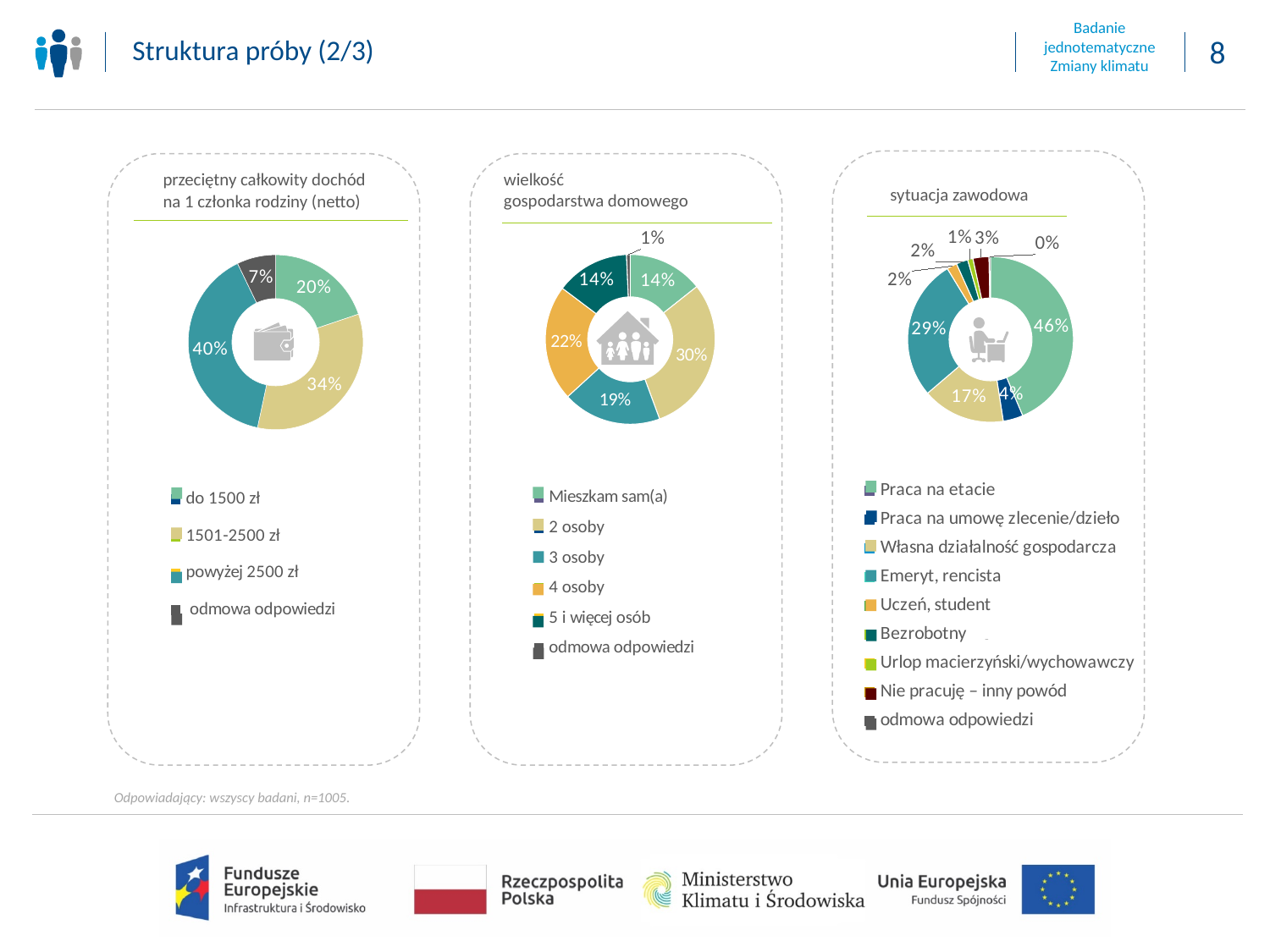
In the chart titled 'przeciętny całkowity dochód na 1 członka rodziny (netto)', what share is 'powyżej 2500 zł'? 40% In the chart titled 'przeciętny całkowity dochód na 1 członka rodziny (netto)', what is the difference between '1501-2500 zł' and 'do 1500 zł'? 14 percentage points In the chart titled 'sytuacja zawodowa', which category has the largest share? Praca na etacie In the chart titled 'sytuacja zawodowa', how many categories does the legend list? 9 In the chart titled 'wielkość gospodarstwa domowego', how many categories does the legend list? 6 What type of chart is used for 'sytuacja zawodowa'? Donut (pie) chart In the chart titled 'wielkość gospodarstwa domowego', what share is '2 osoby'? 30% In the chart titled 'wielkość gospodarstwa domowego', which is larger: '3 osoby' or '4 osoby'? 4 osoby In the chart titled 'przeciętny całkowity dochód na 1 członka rodziny (netto)', which category has the smallest share? odmowa odpowiedzi In the chart titled 'wielkość gospodarstwa domowego', which category has the largest share? 2 osoby In the chart titled 'sytuacja zawodowa', what share is 'Emeryt, rencista'? 29% In the chart titled 'sytuacja zawodowa', what share is 'Własna działalność gospodarcza'? 17%